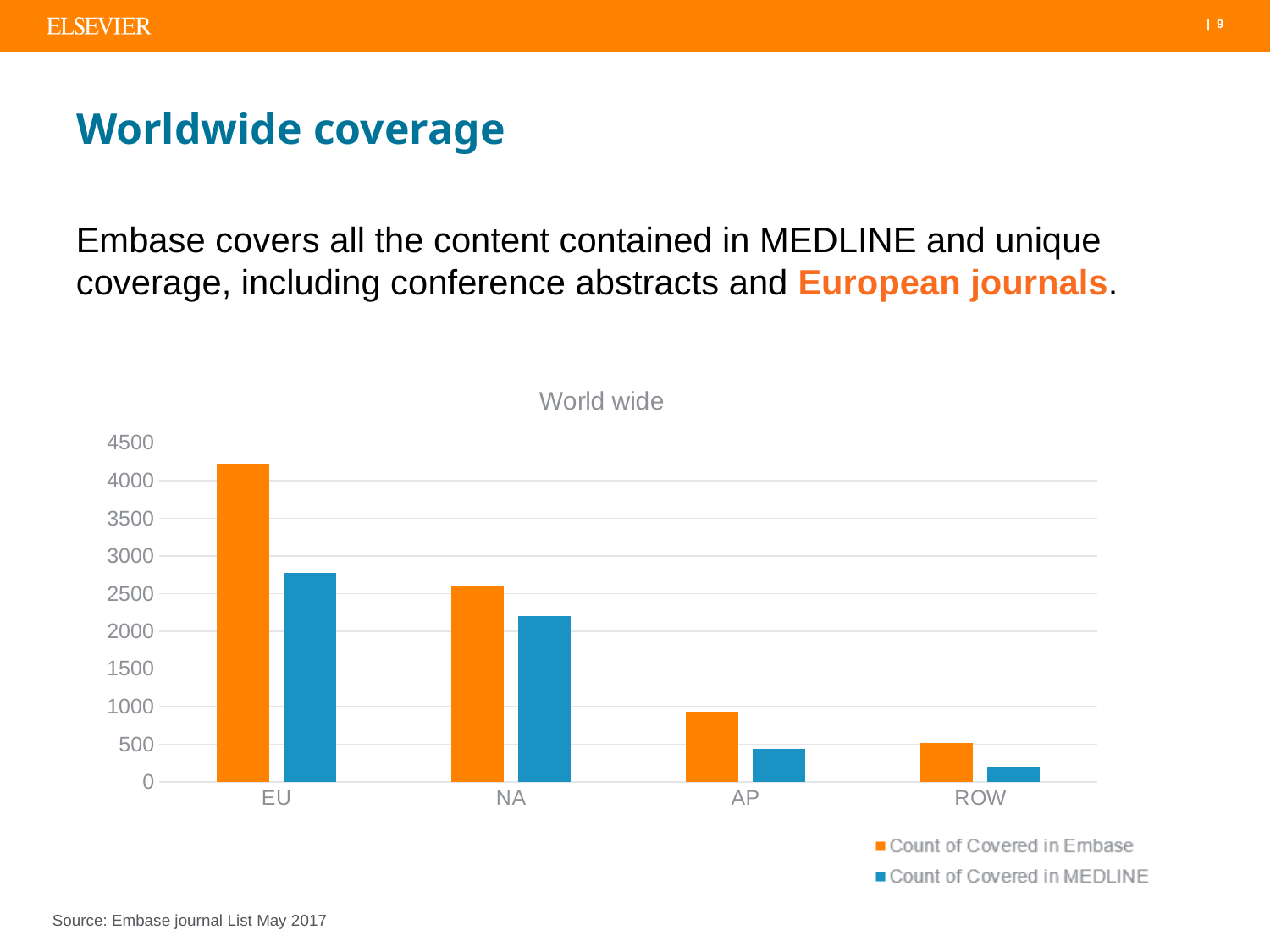
How many series does the chart legend list? 2 Is the Count of Covered in MEDLINE for NA greater or less than 2000? greater Is the Count of Covered in Embase for EU greater or less than 4000? greater Is the Count of Covered in MEDLINE for EU greater or less than 2500? greater For NA, which is larger: Count of Covered in Embase or Count of Covered in MEDLINE? Count of Covered in Embase Which region has the lowest Count of Covered in MEDLINE? ROW Do the Count of Covered in Embase values rise or fall from EU to ROW along the x axis? fall How many regions are shown on the x axis of the chart? 4 Which region has the highest Count of Covered in Embase? EU What type of chart is shown on the slide? bar chart What is the title of the chart? World wide